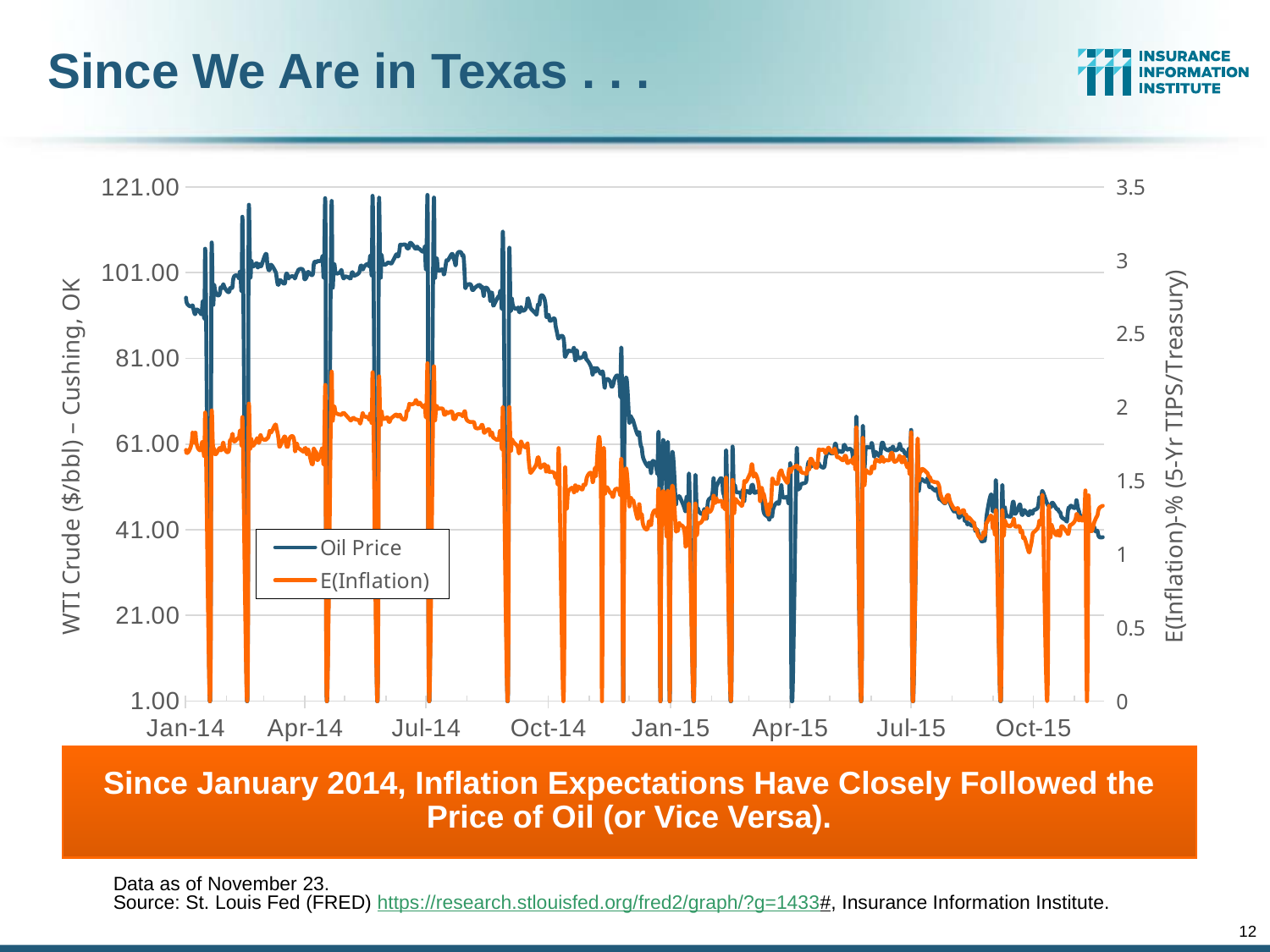
What are the two series named in the legend? Oil Price and E(Inflation) How many series does the legend list? 2 Is the E(Inflation) value at Jan-14 greater or less than 1.5 on the right axis? greater Is the Oil Price value at Oct-15 greater or less than 61.00? less Is the Oil Price value at Jul-14 greater or less than 81.00? greater Does the E(Inflation) series overall rise or fall from Jan-14 to Oct-15? fall Does the Oil Price series overall rise or fall from Jan-14 to Oct-15? fall How many date labels are shown along the x axis? 8 What kind of chart is shown on the slide? Line chart What is the title of the left vertical axis? WTI Crude ($/bbl) – Cushing, OK